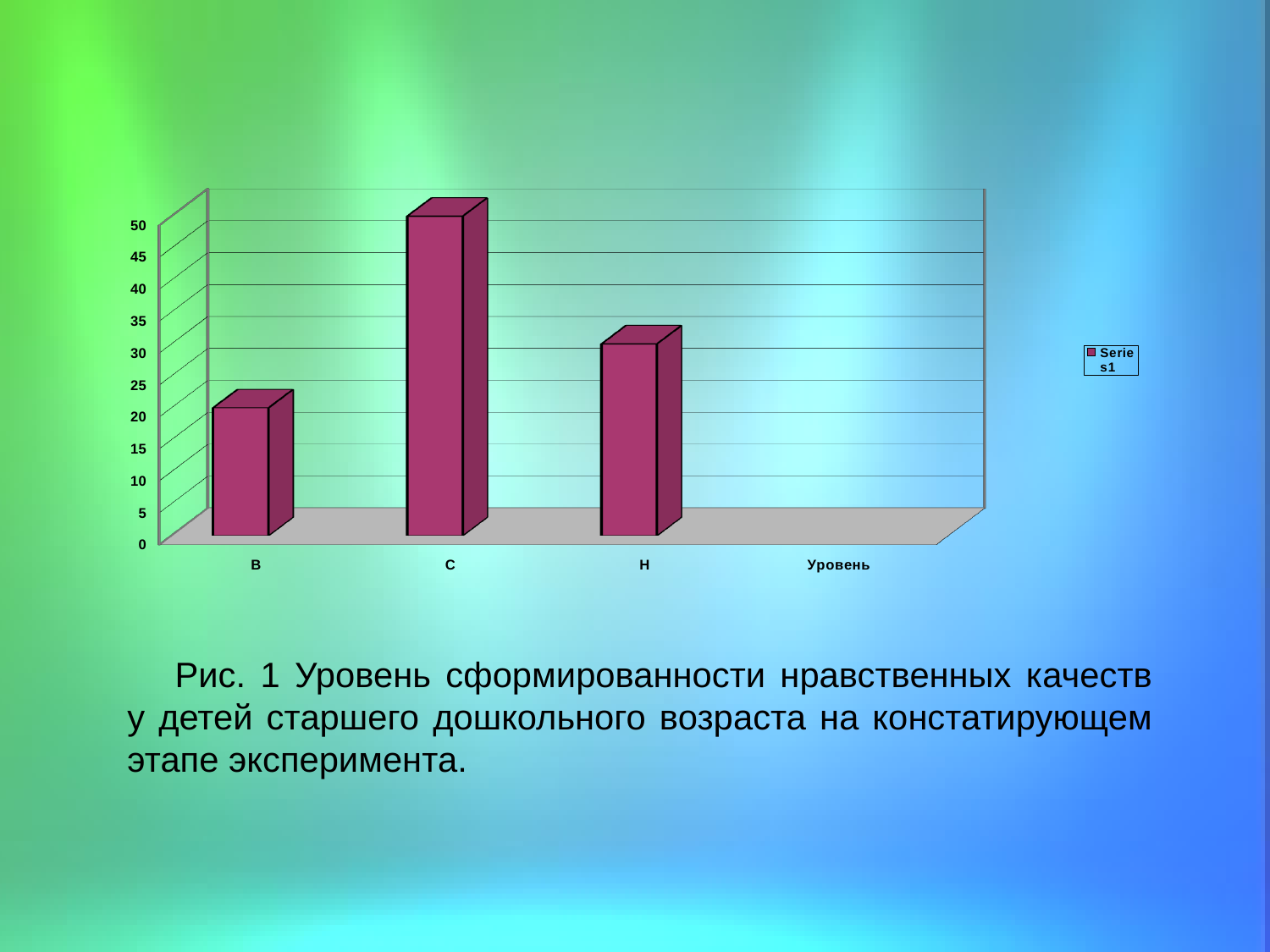
Is the value for Н greater or less than 25? greater Which category has the highest bar? С What is the difference between the values for Н and В? 10 How many bars are plotted in the chart? 3 What is the value for category Н? 30 How many series does the legend list? 1 Which category with a bar has the lowest value? В Which is larger, the value for Н or the value for В? Н What is the value for category В? 20 What is the difference between the values for С and В? 30 What kind of chart is shown on the slide? bar chart What is the value for category С? 50